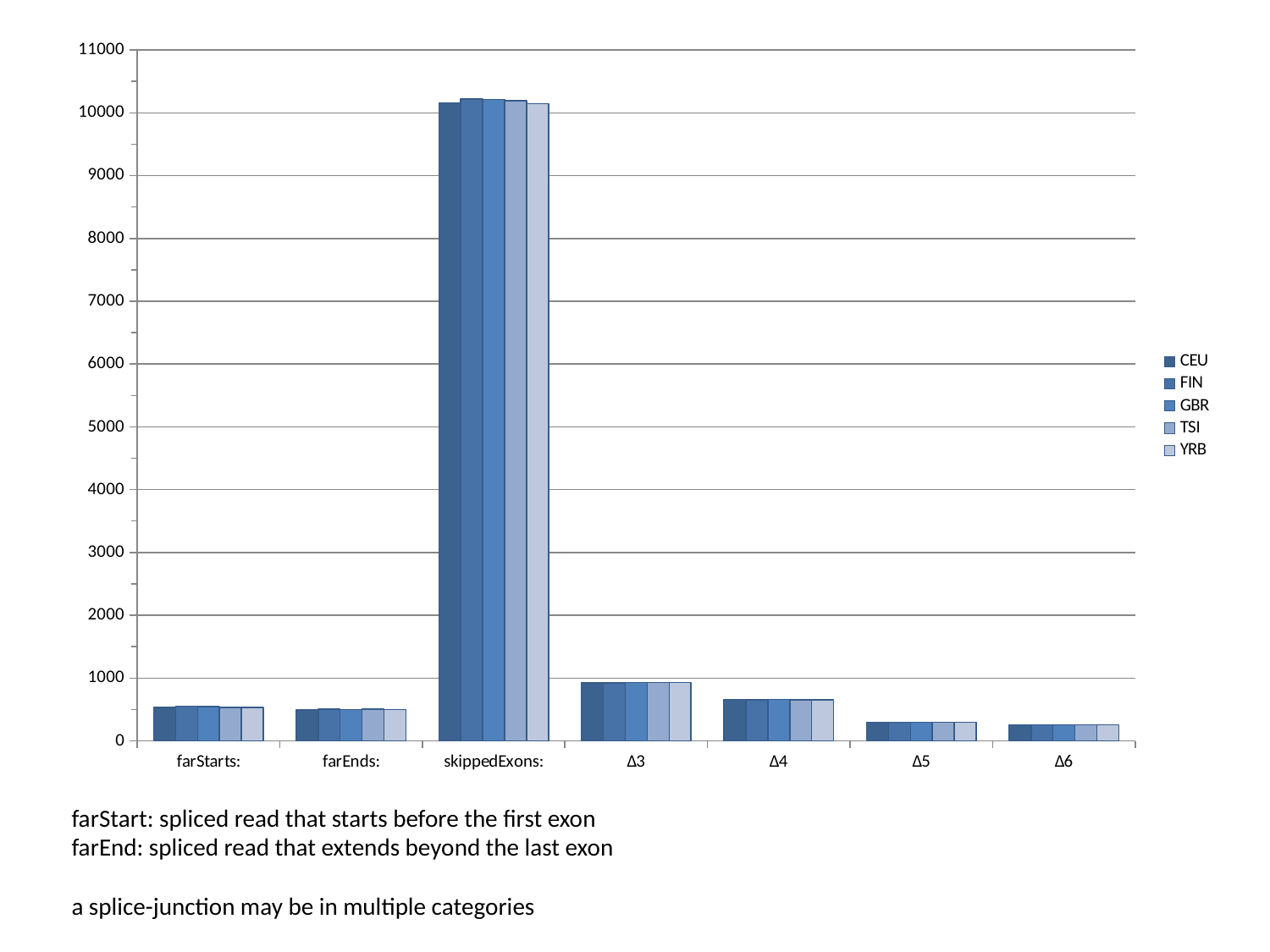
Which is larger for the CEU series: the value for skippedExons: or the value for Δ3? skippedExons: Which series is listed last in the chart's legend? YRB Is the CEU value for Δ3 greater or less than 1000? less How many series does the chart's legend list? 5 What kind of chart is shown on the slide? bar chart Is the CEU value for skippedExons: greater or less than 10000? greater How many categories are shown along the x axis of the chart? 7 Is the FIN value for Δ5 greater or less than 1000? less Which is larger for the TSI series: the value for Δ3 or the value for Δ4? Δ3 Which series is listed first in the chart's legend? CEU Which category has the highest bars in the chart? skippedExons: